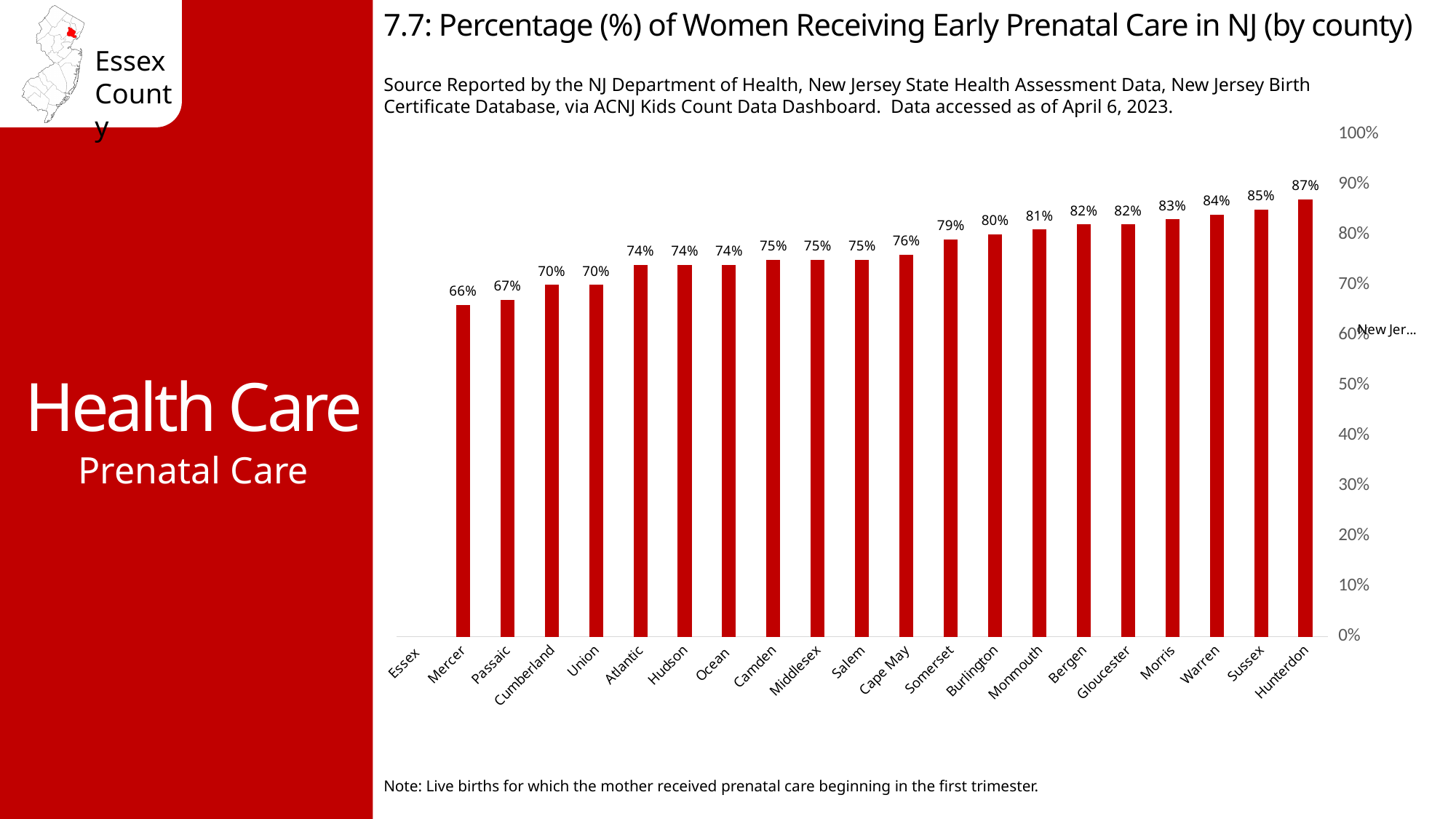
Is the value for Hunterdon greater or less than 80%? greater What is the percentage of women receiving early prenatal care in Sussex? 85% What is the difference in percentage points between Hunterdon and Sussex? 2% What is the title of the chart? 7.7: Percentage (%) of Women Receiving Early Prenatal Care in NJ (by county) How many counties are listed along the x axis? 21 What is the percentage of women receiving early prenatal care in Warren? 84% Which county has the highest percentage of women receiving early prenatal care? Hunterdon What type of chart is shown on the slide? Bar chart What is the percentage of women receiving early prenatal care in Morris? 83% Which is larger, the value for Hunterdon or the value for Morris? Hunterdon Do the bar values generally rise or fall from left to right along the x axis? Rise What is the percentage of women receiving early prenatal care in Hunterdon? 87%